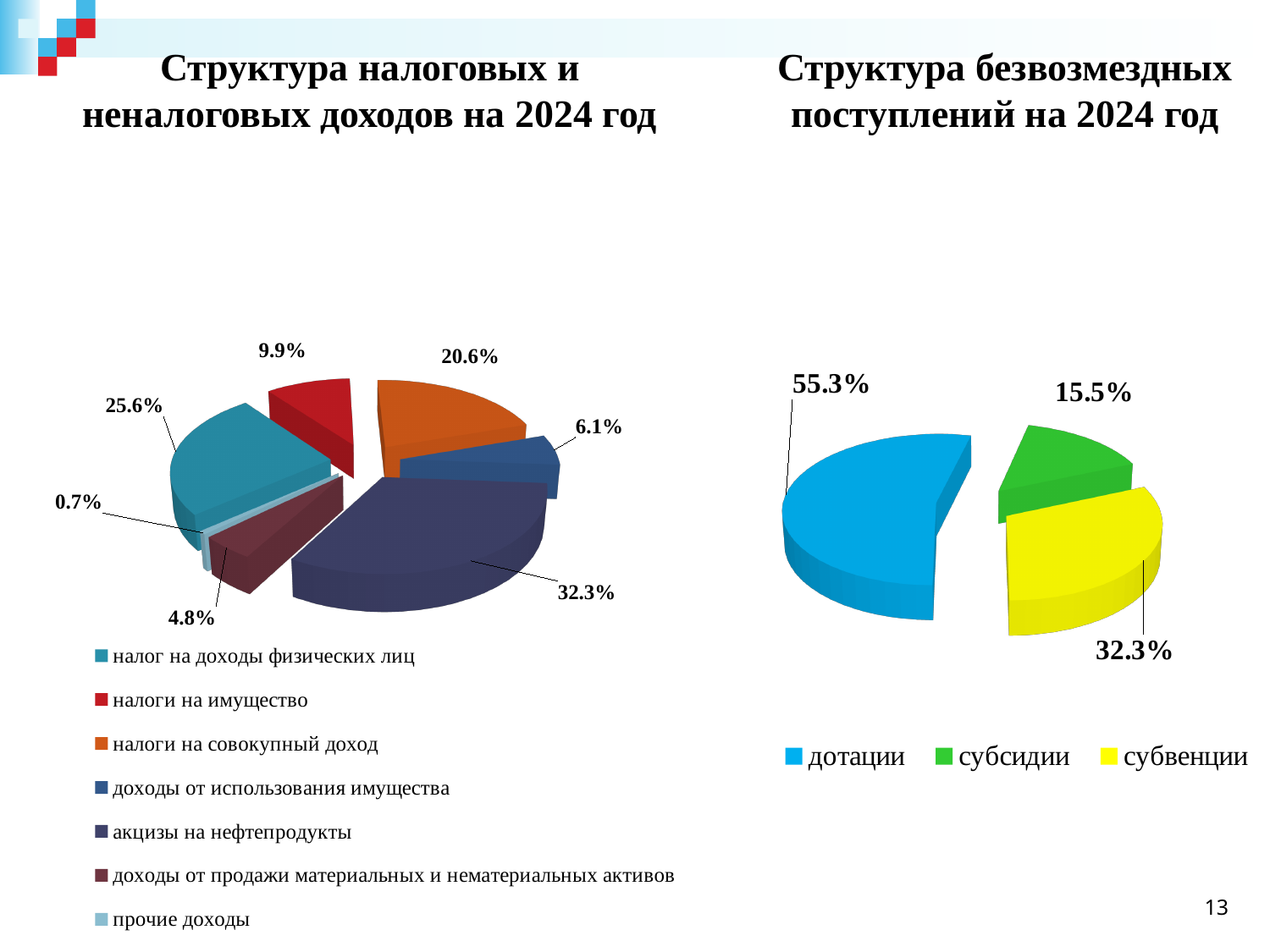
On the chart 'Структура налоговых и неналоговых доходов на 2024 год', what is the difference between the shares of 'налоги на имущество' and 'доходы от продажи материальных и нематериальных активов'? 5.1% On the chart 'Структура налоговых и неналоговых доходов на 2024 год', which category has the smallest share? прочие доходы On the chart 'Структура налоговых и неналоговых доходов на 2024 год', what share is shown for 'акцизы на нефтепродукты'? 32.3% On the chart 'Структура безвозмездных поступлений на 2024 год', which is larger: 'субвенции' or 'субсидии'? субвенции On the chart 'Структура налоговых и неналоговых доходов на 2024 год', how many categories does the legend list? 7 On the chart 'Структура налоговых и неналоговых доходов на 2024 год', which category has the largest share? акцизы на нефтепродукты On the chart 'Структура налоговых и неналоговых доходов на 2024 год', what share is shown for 'налог на доходы физических лиц'? 25.6% On the chart 'Структура безвозмездных поступлений на 2024 год', what is the difference between the shares of 'дотации' and 'субвенции'? 23.0% On the chart 'Структура безвозмездных поступлений на 2024 год', what share is shown for 'дотации'? 55.3% On the chart 'Структура налоговых и неналоговых доходов на 2024 год', what share is shown for 'налоги на совокупный доход'? 20.6% On the chart 'Структура безвозмездных поступлений на 2024 год', what share is shown for 'субсидии'? 15.5% What type of chart is 'Структура безвозмездных поступлений на 2024 год'? pie chart